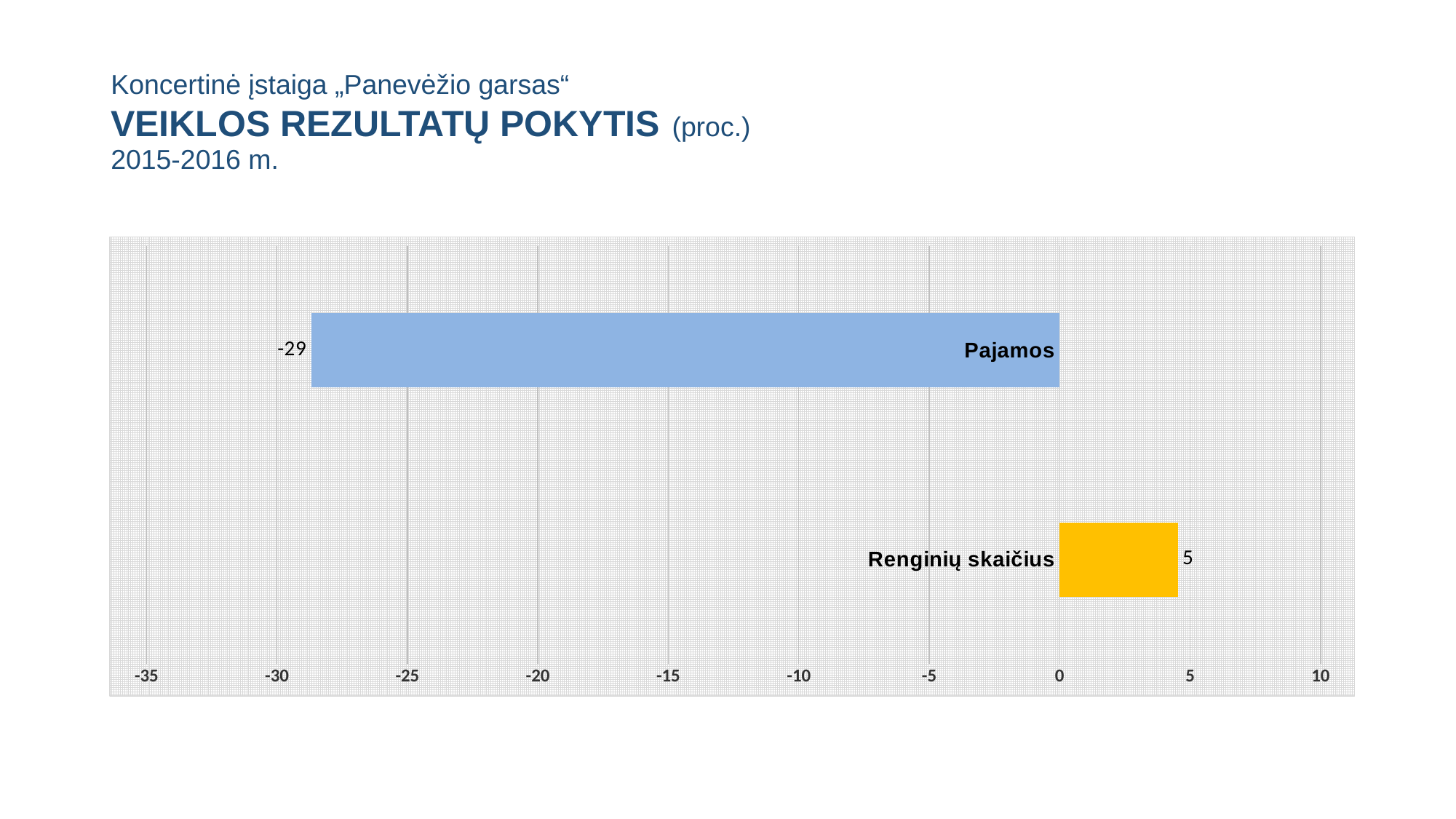
Is the value for Renginių skaičius greater or less than 0? greater Which category has the highest value? Renginių skaičius What colour is the bar for Renginių skaičius? yellow Which category has the lowest value? Pajamos How many categories are shown in the chart? 2 What is the lowest value shown on the horizontal axis? -35 What kind of chart is shown on the slide? bar chart Which is larger, the value for Pajamos or the value for Renginių skaičius? Renginių skaičius Is the value for Pajamos greater or less than -25? less What is the value for Renginių skaičius? 5 What is the value for Pajamos? -29 What is the difference between the value for Renginių skaičius and the value for Pajamos? 34